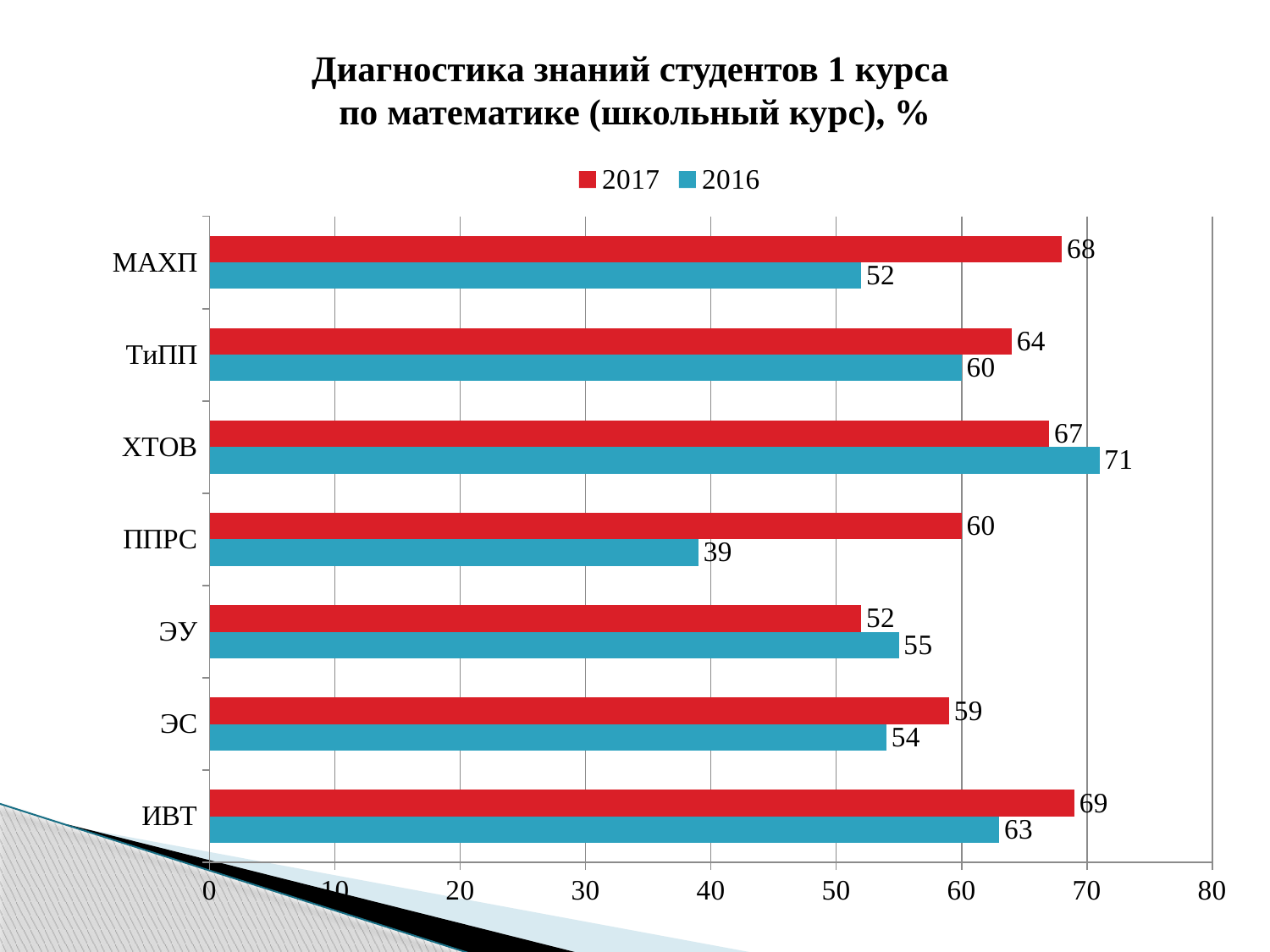
What is the 2016 value for МАХП? 52 What is the difference between the 2017 and 2016 values for ППРС? 21 Which category has the lowest 2017 value? ЭУ How many series does the legend list? 2 What is the 2017 value for ППРС? 60 Which is larger for ЭУ, the 2017 value or the 2016 value? 2016 How many categories are shown on the chart? 7 Which category has the highest 2016 value? ХТОВ What kind of chart is shown on the slide? bar chart Which category has the lowest 2016 value? ППРС What is the 2016 value for ХТОВ? 71 Which colour represents the 2017 series? red